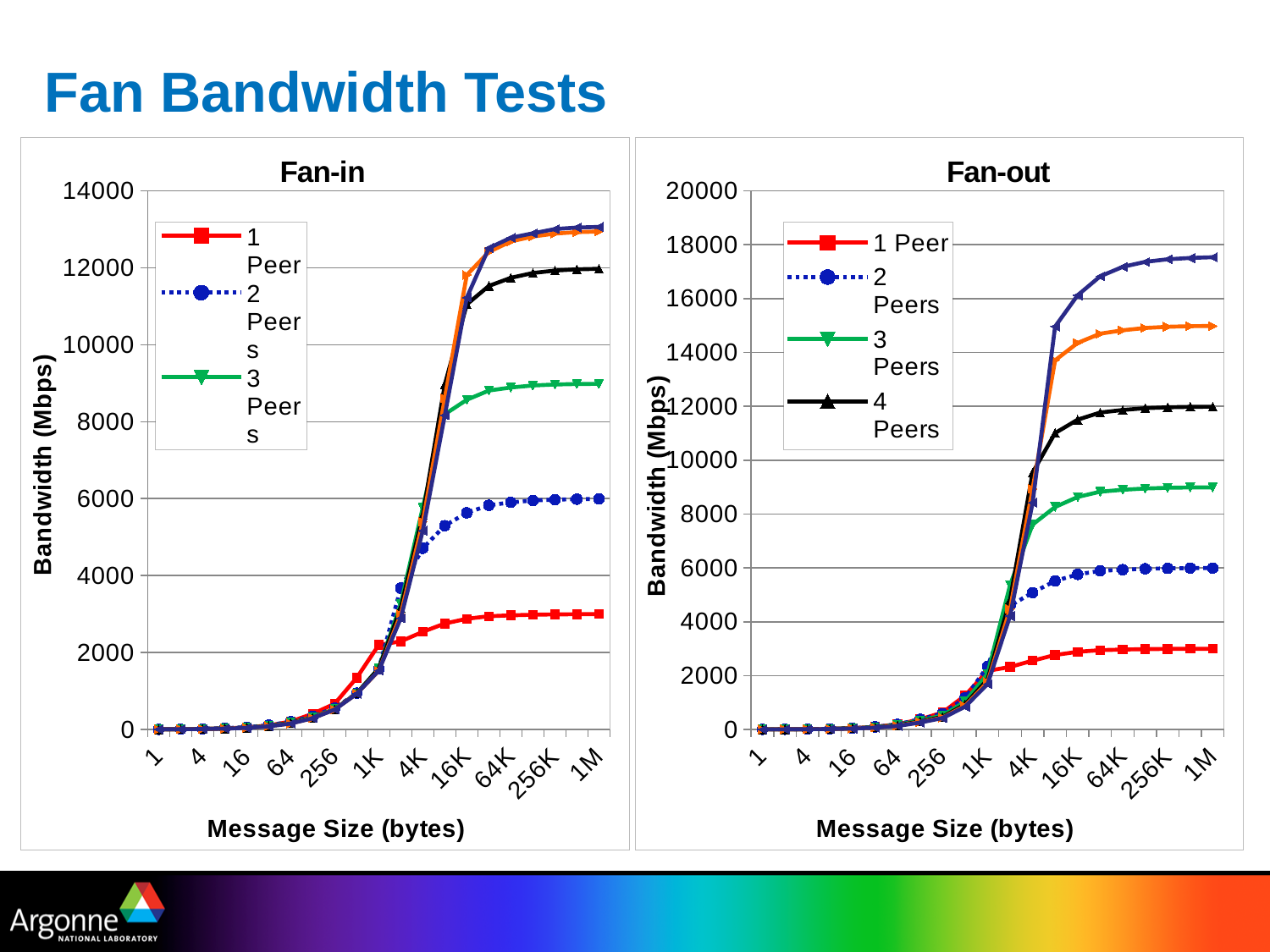
How many message size labels are shown on the x axis of the Fan-out chart? 11 What kind of chart is the Fan-in chart? line chart In the Fan-in chart, is the value for 3 Peers at message size 1M greater or less than 8000? greater In the Fan-out chart, is the value for 4 Peers at message size 1M greater or less than 10000? greater How many series does the legend of the Fan-in chart list? 3 In the Fan-out chart, do the bandwidth values rise or fall as message size increases? rise What is the y-axis label of the Fan-in chart? Bandwidth (Mbps) In the Fan-in chart, at message size 1M, which is larger: the value for 3 Peers or the value for 1 Peer? 3 Peers In the Fan-in chart, is the value for 1 Peer at message size 1M greater or less than 4000? less In the Fan-out chart, at message size 1M, which is larger: the value for 4 Peers or the value for 2 Peers? 4 Peers How many series does the legend of the Fan-out chart list? 4